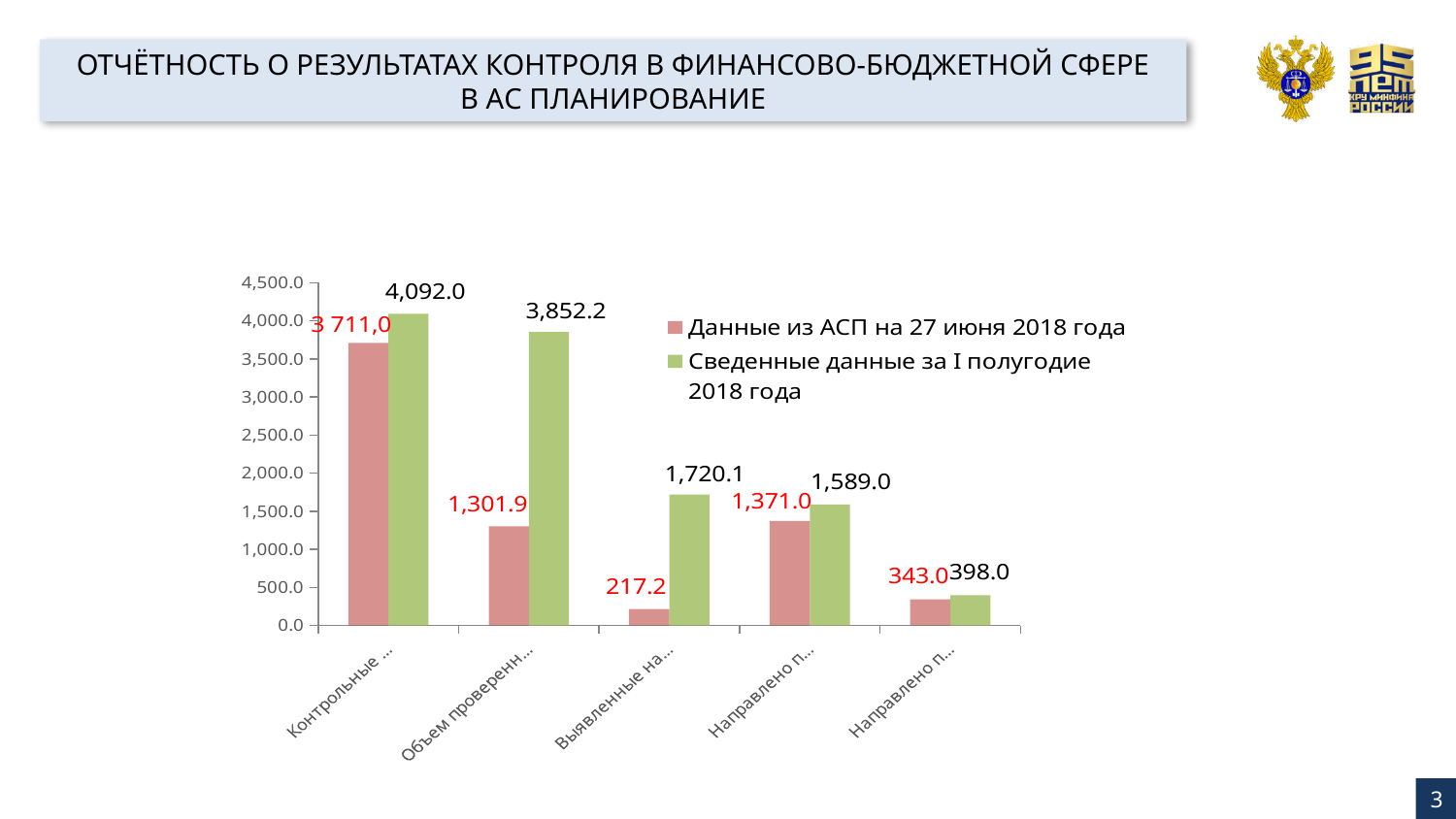
Which category has the lowest value in the 'Данные из АСП на 27 июня 2018 года' series? Выявленные на... (the third category) What kind of chart is shown on the slide? bar chart What is the value of the 'Сведенные данные за I полугодие 2018 года' series for the first category ('Контрольные ...')? 4,092.0 Which category has the highest value in the 'Сведенные данные за I полугодие 2018 года' series? Контрольные ... (the first category) For the second category ('Объем проверенн...'), what is the difference between the 'Сведенные данные' value and the 'Данные из АСП' value? 2,550.3 For the fourth category, which series has the larger value: 'Данные из АСП на 27 июня 2018 года' or 'Сведенные данные за I полугодие 2018 года'? Сведенные данные за I полугодие 2018 года Do the values of the 'Сведенные данные за I полугодие 2018 года' series rise or fall from left to right along the x axis? fall What is the value of the 'Данные из АСП на 27 июня 2018 года' series for the second category ('Объем проверенн...')? 1,301.9 What is the value of the 'Сведенные данные за I полугодие 2018 года' series for the third category ('Выявленные на...')? 1,720.1 How many categories are plotted along the x axis of the chart? 5 How many series does the chart legend list? 2 What is the value of the 'Данные из АСП на 27 июня 2018 года' series for the fifth (last) category? 343.0